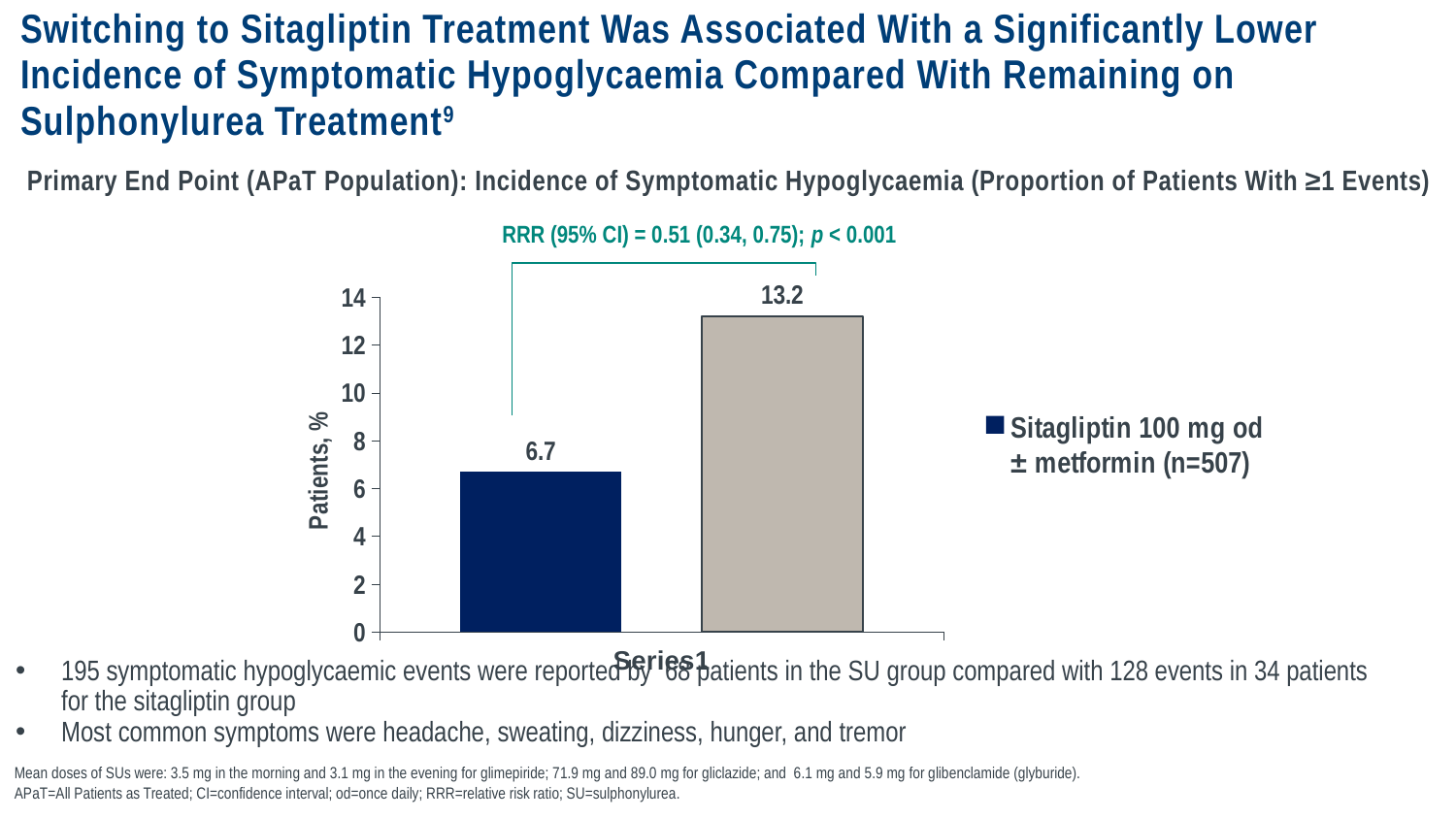
How many entries does the chart legend list? 1 Is the value for the grey bar greater or less than 12? greater What kind of chart is shown on the slide? bar chart How many bars are plotted in the chart? 2 What is the highest tick value shown on the y axis? 14 What is the value shown for Sitagliptin 100 mg od ± metformin (n=507)? 6.7 What is the difference between the grey bar value (13.2) and the Sitagliptin bar value (6.7)? 6.5 Is the value for Sitagliptin 100 mg od ± metformin larger or smaller than the value for the grey bar? smaller Which bar is the tallest, the dark blue bar or the grey bar? the grey bar What is the label on the y axis of the chart? Patients, % Is the value for Sitagliptin 100 mg od ± metformin greater or less than 8? less What value is labelled on the grey bar? 13.2